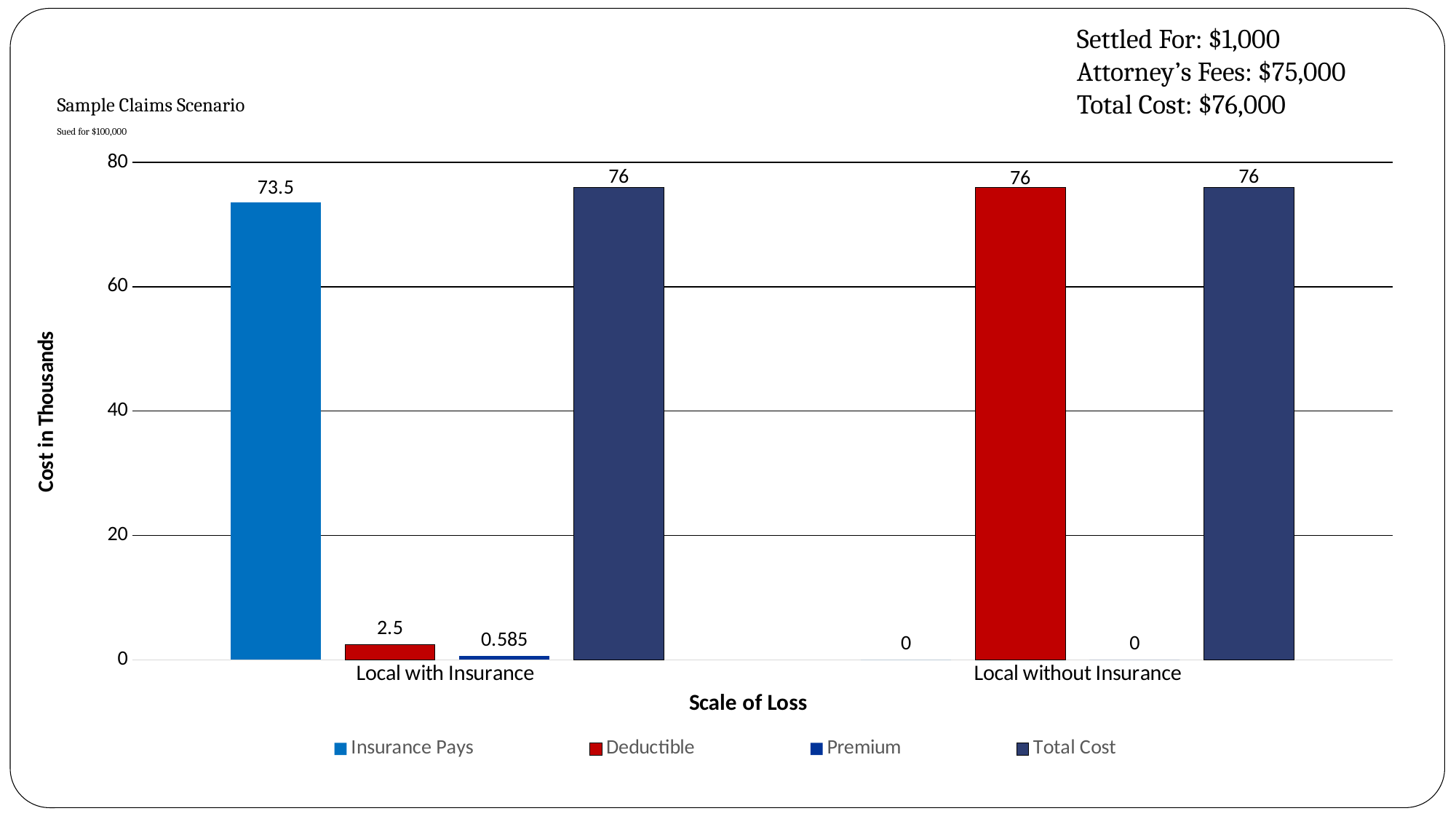
What is the Insurance Pays value for Local without Insurance? 0 What is the Premium value for Local with Insurance? 0.585 What is the Deductible value for Local without Insurance? 76 Which series has the lowest value for Local with Insurance? Premium What is the value of Insurance Pays for Local with Insurance? 73.5 What is the difference between the Total Cost and Insurance Pays for Local with Insurance? 2.5 What kind of chart is shown on the slide? Bar chart Which is larger for Local with Insurance: Deductible or Premium? Deductible How many categories are shown on the x axis? 2 How many series does the legend list? 4 What is the Total Cost for Local with Insurance? 76 What is the title of the y axis? Cost in Thousands